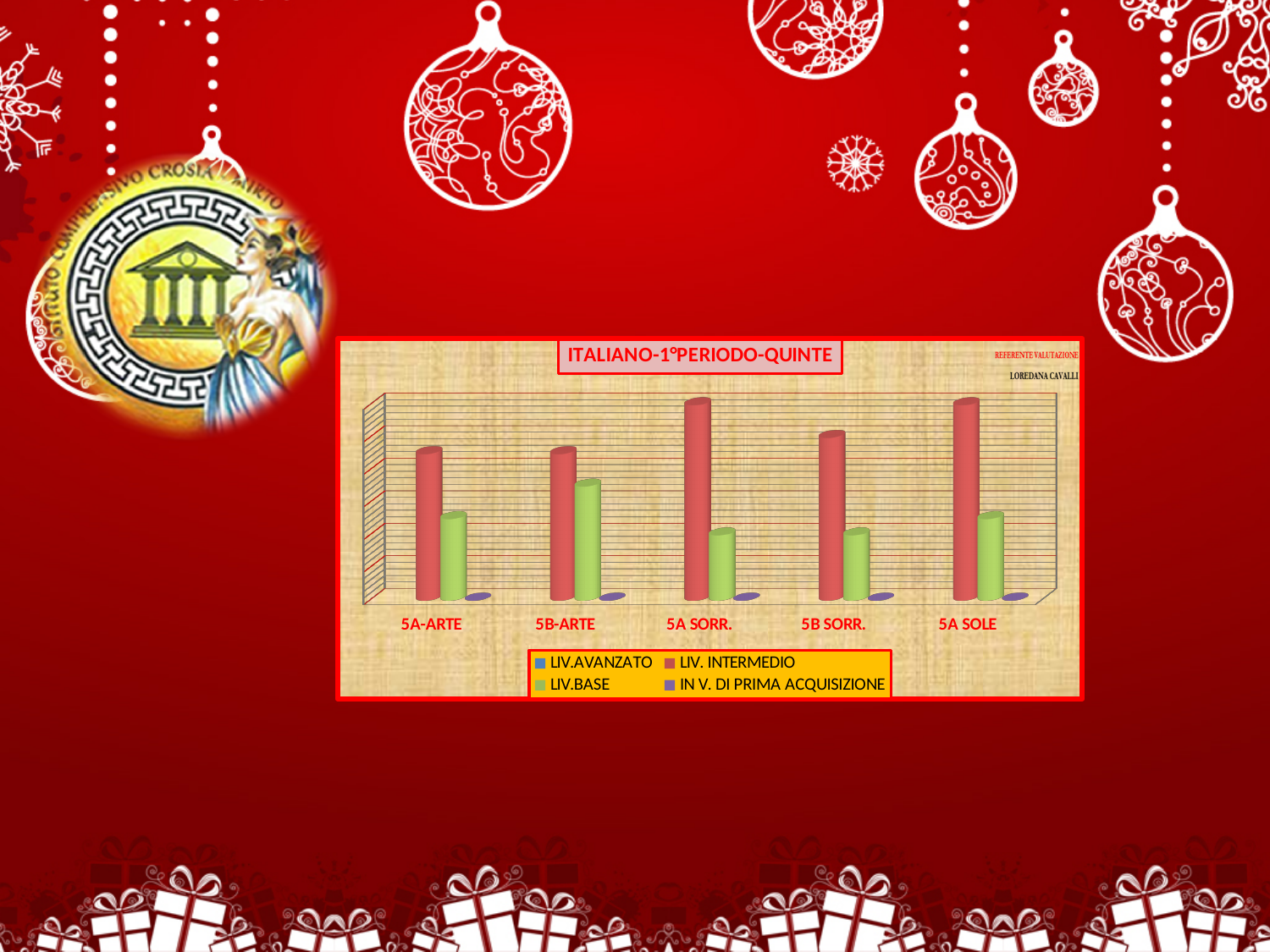
Is the LIV. INTERMEDIO bar for 5A SORR. larger or smaller than the LIV. INTERMEDIO bar for 5A-ARTE? larger How many series does the chart's legend list? 4 For 5B SORR., which is larger: the LIV. INTERMEDIO bar or the LIV.BASE bar? LIV. INTERMEDIO Is the LIV.BASE bar for 5B-ARTE larger or smaller than the LIV.BASE bar for 5A SOLE? larger Which series has the tallest bar in every class shown in the chart? LIV. INTERMEDIO Which series is shown in green in the chart? LIV.BASE Which class has the highest LIV.BASE bar? 5B-ARTE What is the title of the chart? ITALIANO-1°PERIODO-QUINTE What kind of chart is shown on the slide? bar chart How many categories (classes) are shown on the x axis of the chart? 5